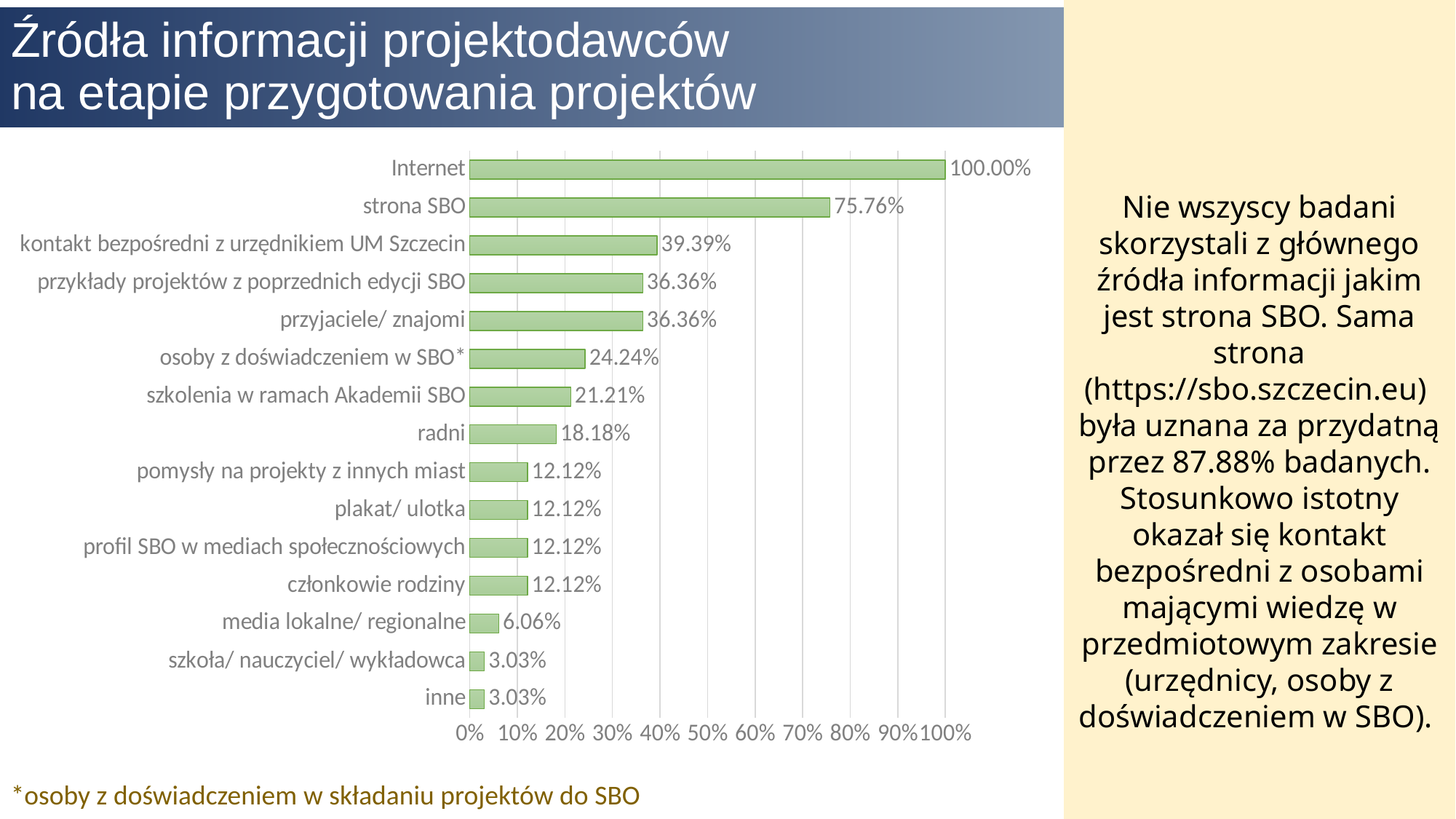
What kind of chart is shown on the slide? bar chart What is the value for strona SBO? 75.76% How many categories are shown in the chart? 15 Is the value for przyjaciele/ znajomi greater or less than 30%? greater What colour are the bars in the chart? green What is the value for media lokalne/ regionalne? 6.06% Which category has the highest value? Internet What is the difference between the values for kontakt bezpośredni z urzędnikiem UM Szczecin and szkolenia w ramach Akademii SBO? 18.18% What is the difference between the values for Internet and strona SBO? 24.24% What is the value for radni? 18.18% What is the value for Internet? 100.00% Which is larger: the value for osoby z doświadczeniem w SBO* or the value for radni? osoby z doświadczeniem w SBO*